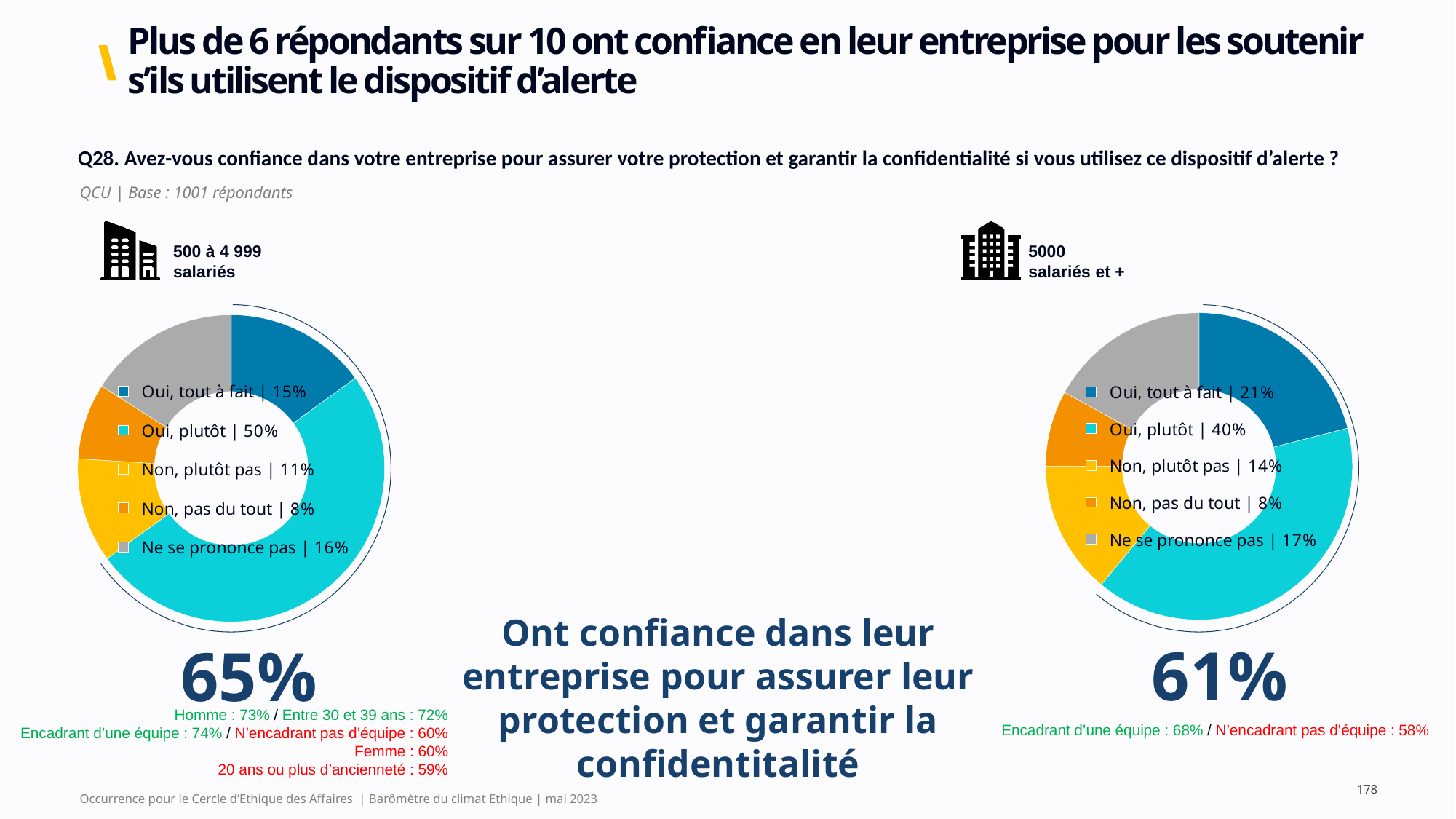
In the '5000 salariés et +' chart, which category has the smallest share? Non, pas du tout In the '5000 salariés et +' chart, what is the combined share of 'Non, plutôt pas' and 'Non, pas du tout'? 22% What kind of chart is used for the '5000 salariés et +' data? Doughnut (pie) chart Which is larger: 'Oui, tout à fait' in the '500 à 4 999 salariés' chart or 'Oui, tout à fait' in the '5000 salariés et +' chart? 5000 salariés et + In the '5000 salariés et +' chart, what is the value for 'Oui, tout à fait'? 21% What is the difference between 'Oui, plutôt' in the '500 à 4 999 salariés' chart and 'Oui, plutôt' in the '5000 salariés et +' chart? 10 percentage points What colour represents 'Ne se prononce pas' in both charts? Grey How many categories does the '500 à 4 999 salariés' chart show? 5 In the '500 à 4 999 salariés' chart, what is the value for 'Oui, plutôt'? 50% In the '500 à 4 999 salariés' chart, which category has the largest share? Oui, plutôt In the '5000 salariés et +' chart, what is the value for 'Ne se prononce pas'? 17% In the '500 à 4 999 salariés' chart, what is the combined share of 'Oui, tout à fait' and 'Oui, plutôt'? 65%